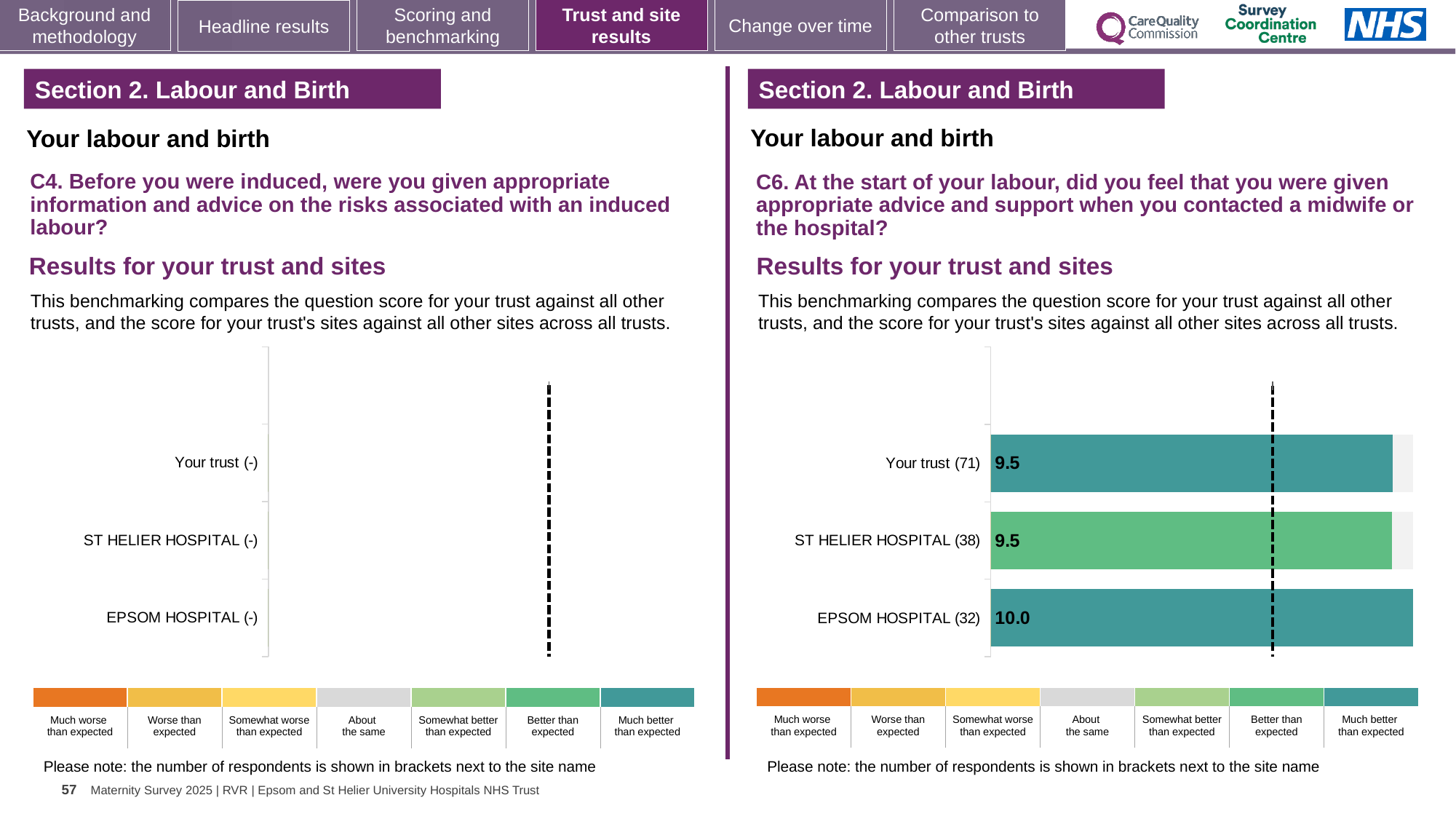
In the C6 chart on the right, what is the score for EPSOM HOSPITAL? 10.0 What kind of chart is used for the C6 results on the right? Bar chart How many bars are plotted in the C6 chart on the right? 3 In the C6 chart on the right, how many respondents are shown for Your trust? 71 In the C6 chart on the right, which benchmark category does the colour of the EPSOM HOSPITAL bar correspond to in the legend? Much better than expected In the C6 chart on the right, which site has the highest score? EPSOM HOSPITAL In the C6 chart on the right, how many respondents are shown for ST HELIER HOSPITAL? 38 In the C6 chart on the right, what is the score for ST HELIER HOSPITAL? 9.5 In the C6 chart on the right, what is the score for Your trust? 9.5 In the C6 chart on the right, what is the difference between the scores for EPSOM HOSPITAL and ST HELIER HOSPITAL? 0.5 In the C6 chart on the right, which is larger, the score for EPSOM HOSPITAL or the score for Your trust? EPSOM HOSPITAL How many categories are listed on the axis of the C4 chart on the left? 3